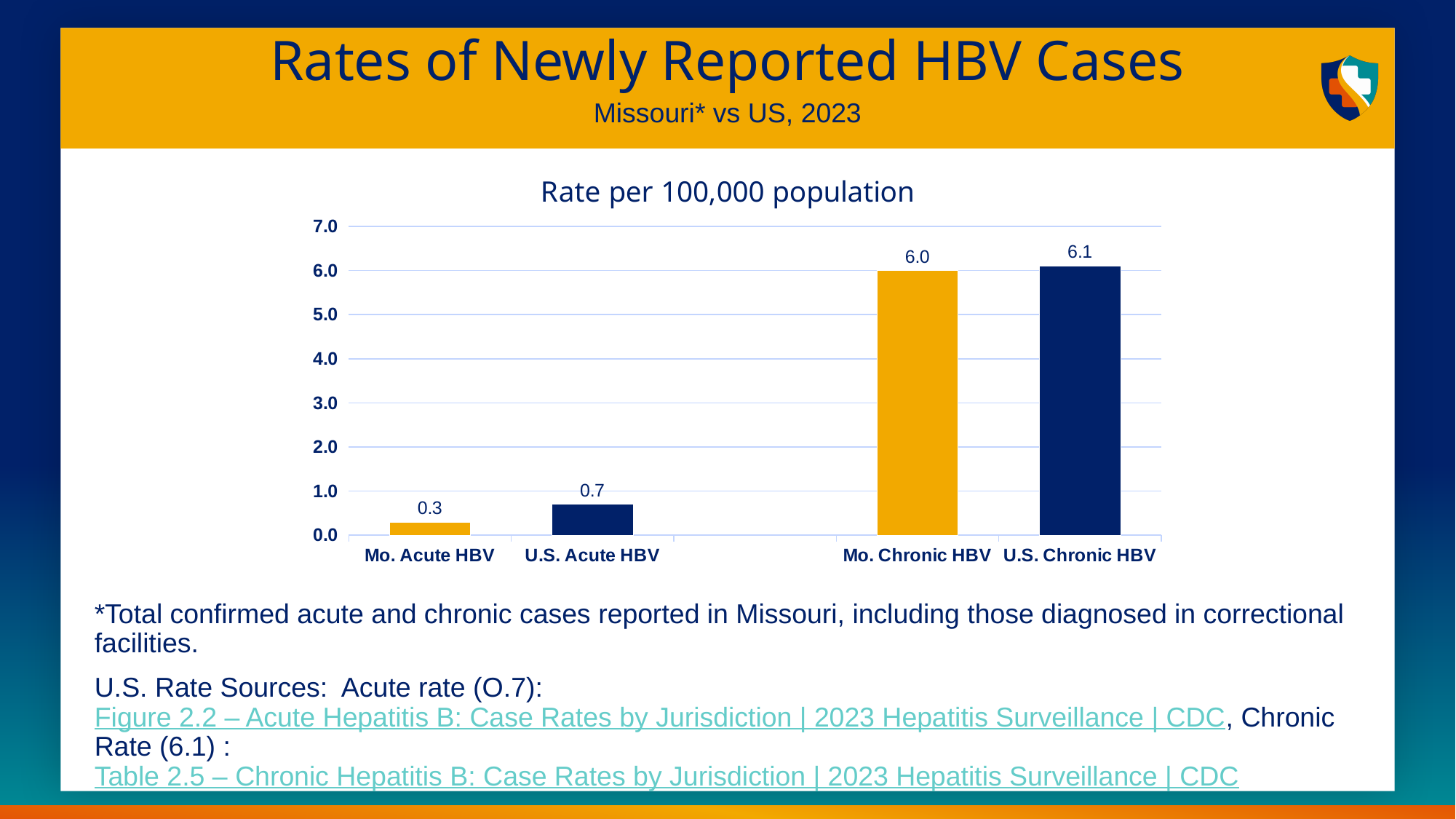
Which category has the highest rate? U.S. Chronic HBV Which is larger, the rate for Mo. Acute HBV or the rate for U.S. Acute HBV? U.S. Acute HBV How many categories are shown on the chart? 4 What kind of chart is shown on the slide? Bar chart What is the difference between the U.S. Acute HBV rate and the Mo. Acute HBV rate? 0.4 Which category has the lowest rate? Mo. Acute HBV What is the rate per 100,000 population for Mo. Chronic HBV? 6.0 What is the rate per 100,000 population for Mo. Acute HBV? 0.3 Is the value for Mo. Chronic HBV greater or less than 5.0? greater What is the title of the chart? Rate per 100,000 population What is the rate per 100,000 population for U.S. Chronic HBV? 6.1 What is the difference between the U.S. Chronic HBV rate and the Mo. Chronic HBV rate? 0.1